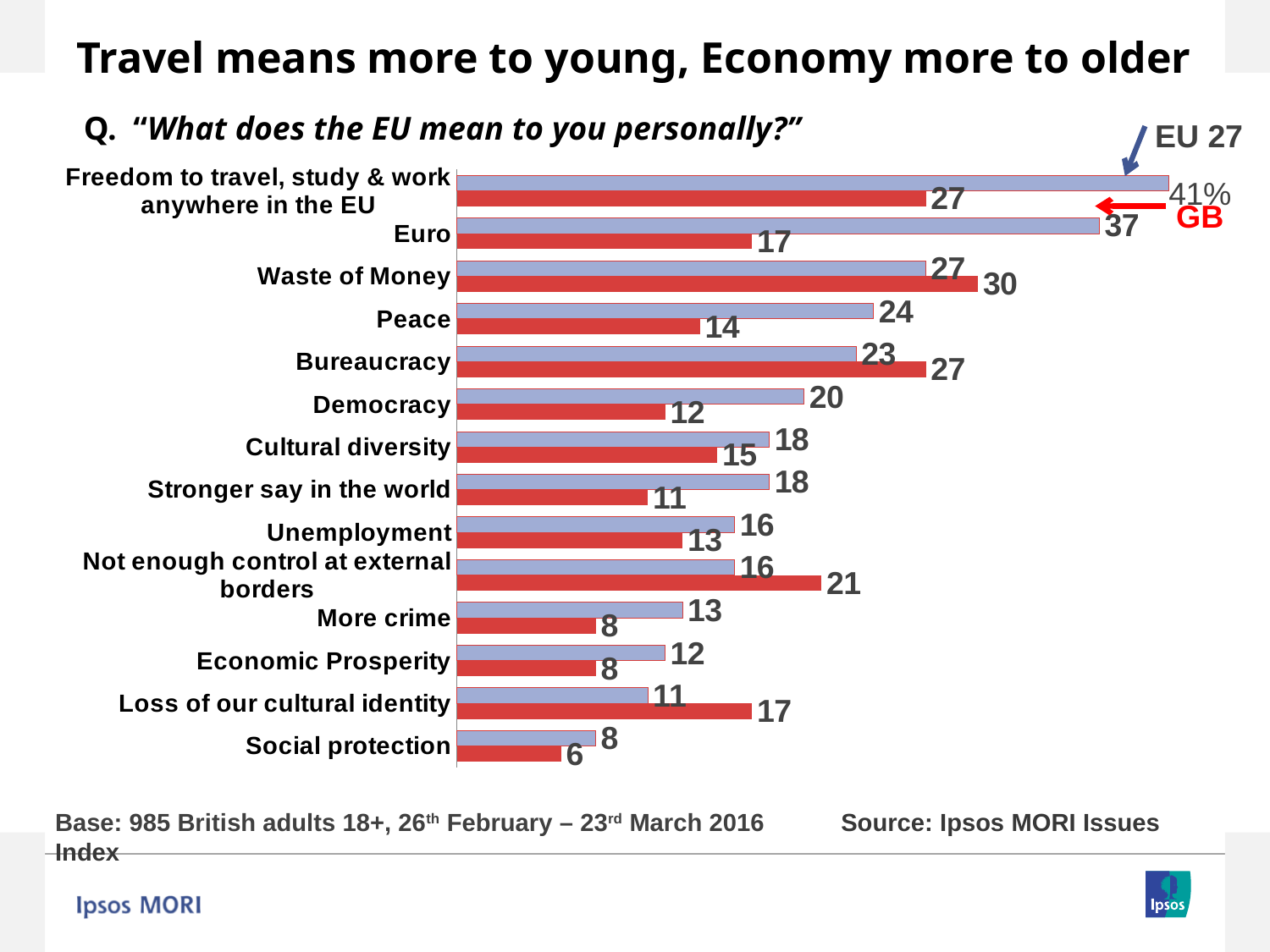
Which category has the lowest GB value? Social protection Which is larger for Bureaucracy, the EU 27 value or the GB value? GB What kind of chart is shown on the slide? Bar chart How many categories are shown in the chart? 14 What is the difference between the EU 27 and GB values for Euro? 20 What is the EU 27 value for Peace? 24 Which is larger for Democracy, the EU 27 value or the GB value? EU 27 How many series does the chart show? 2 Which category has the highest EU 27 value? Freedom to travel, study & work anywhere in the EU What is the GB value for Not enough control at external borders? 21 Which colour represents the GB series? Red What is the GB value for Waste of Money? 30